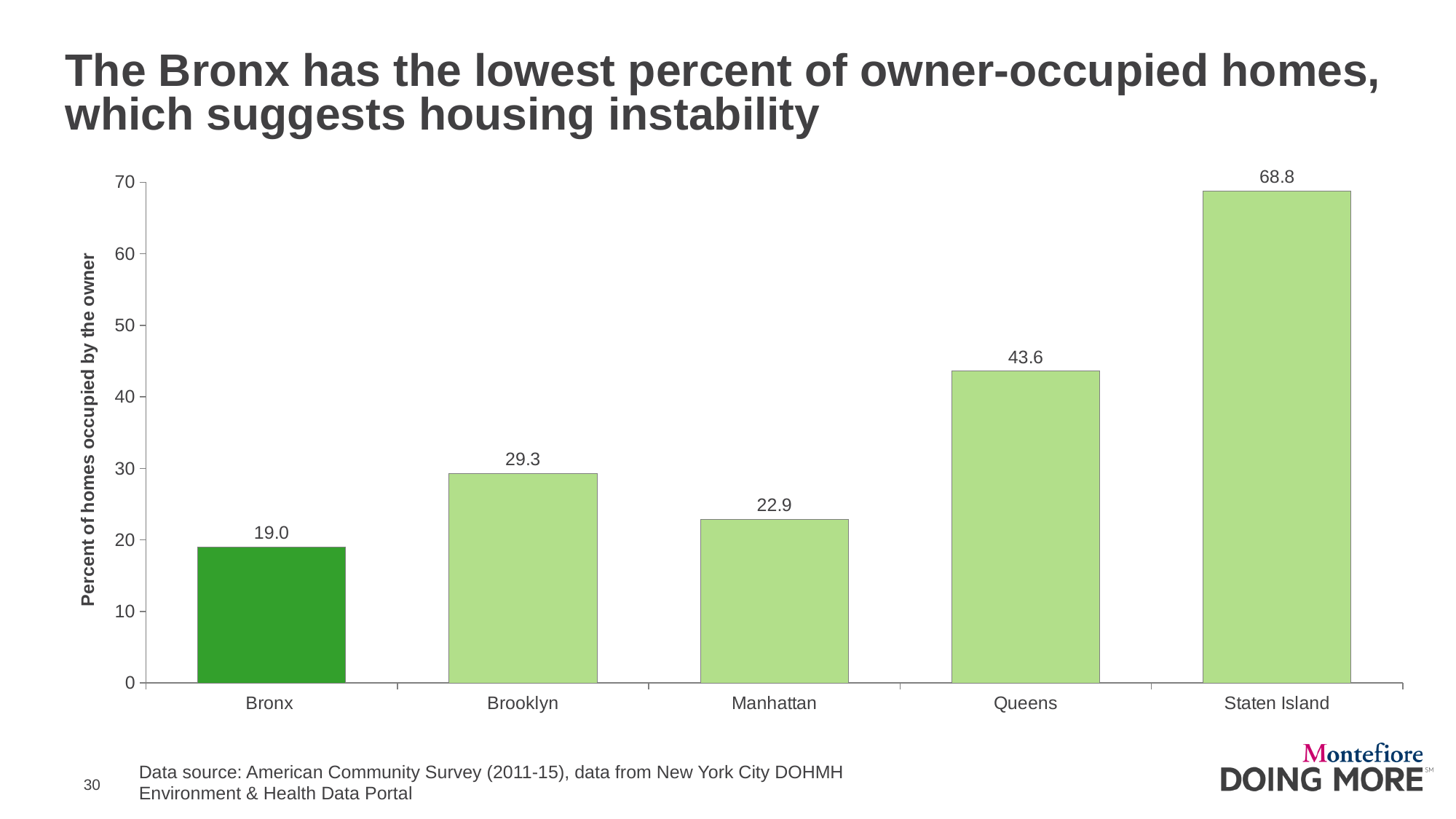
Which has a higher percent of owner-occupied homes, Brooklyn or Queens? Queens What is the difference between the percent of owner-occupied homes in Staten Island and the Bronx? 49.8 What is the difference between the percent of owner-occupied homes in Brooklyn and Manhattan? 6.4 Which borough has the highest percent of owner-occupied homes? Staten Island What is the percent of homes occupied by the owner in Manhattan? 22.9 What is the label of the vertical axis? Percent of homes occupied by the owner What is the percent of homes occupied by the owner in Queens? 43.6 What kind of chart is shown on the slide? Bar chart Is the value for Staten Island greater or less than 60? greater What is the percent of homes occupied by the owner in the Bronx? 19.0 How many boroughs are shown on the chart? 5 Which borough has the lowest percent of owner-occupied homes? Bronx